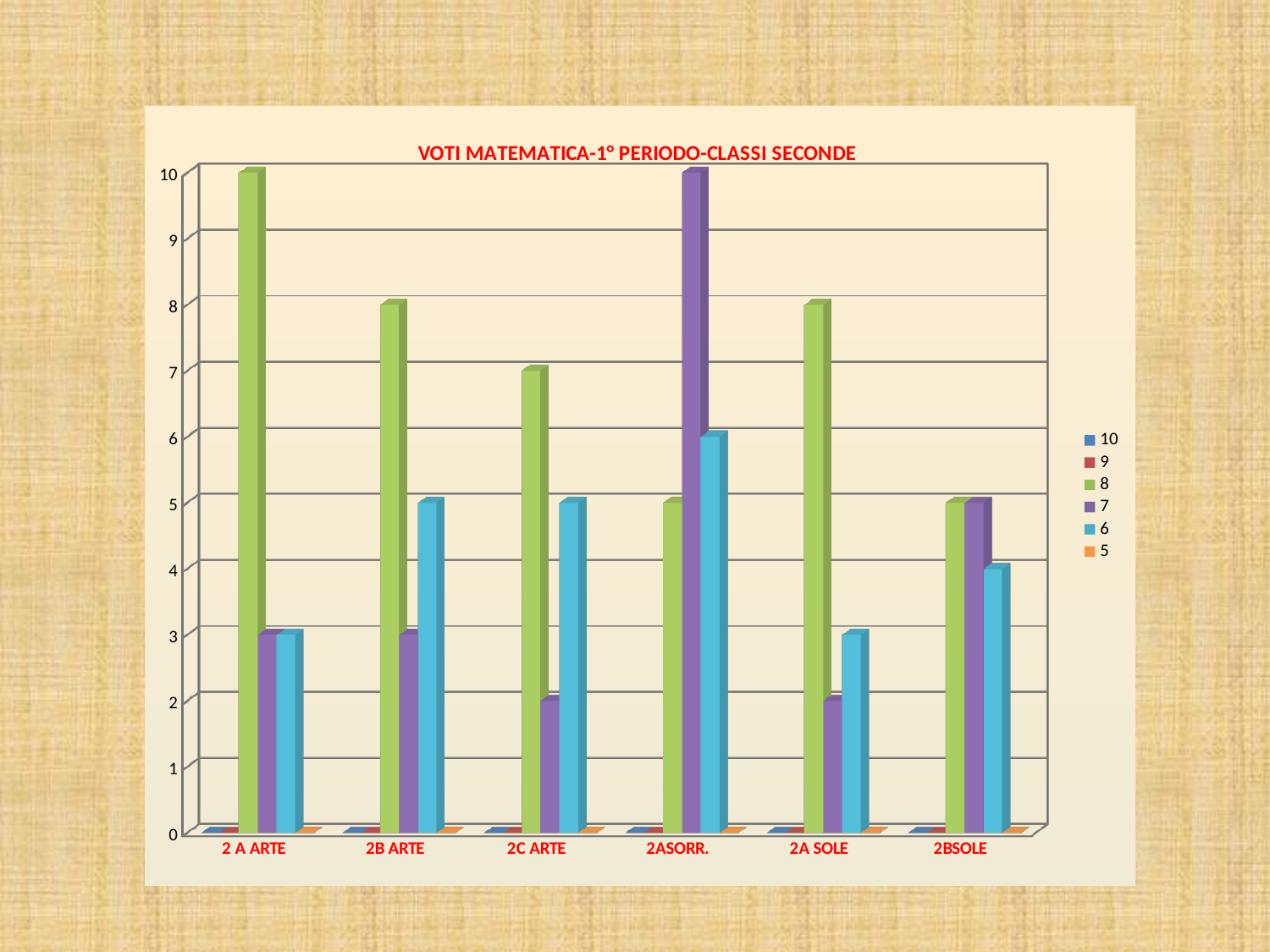
Which class has the highest value for series 7? 2ASORR. What kind of chart is shown on the slide? bar chart Is the value for series 8 in 2 A ARTE greater or less than 9? greater Is the value for series 6 in 2ASORR. greater or less than 5? greater What is the title of the chart? VOTI MATEMATICA-1° PERIODO-CLASSI SECONDE Is the value for series 7 in 2C ARTE greater or less than 3? less In 2A SOLE, which is larger: the value for series 8 or the value for series 6? series 8 How many series does the legend list? 6 Which class has the highest value for series 6? 2ASORR. How many classes (categories) are shown on the x axis? 6 Which class has the highest value for series 8? 2 A ARTE Which colour represents series 8 in the legend? green